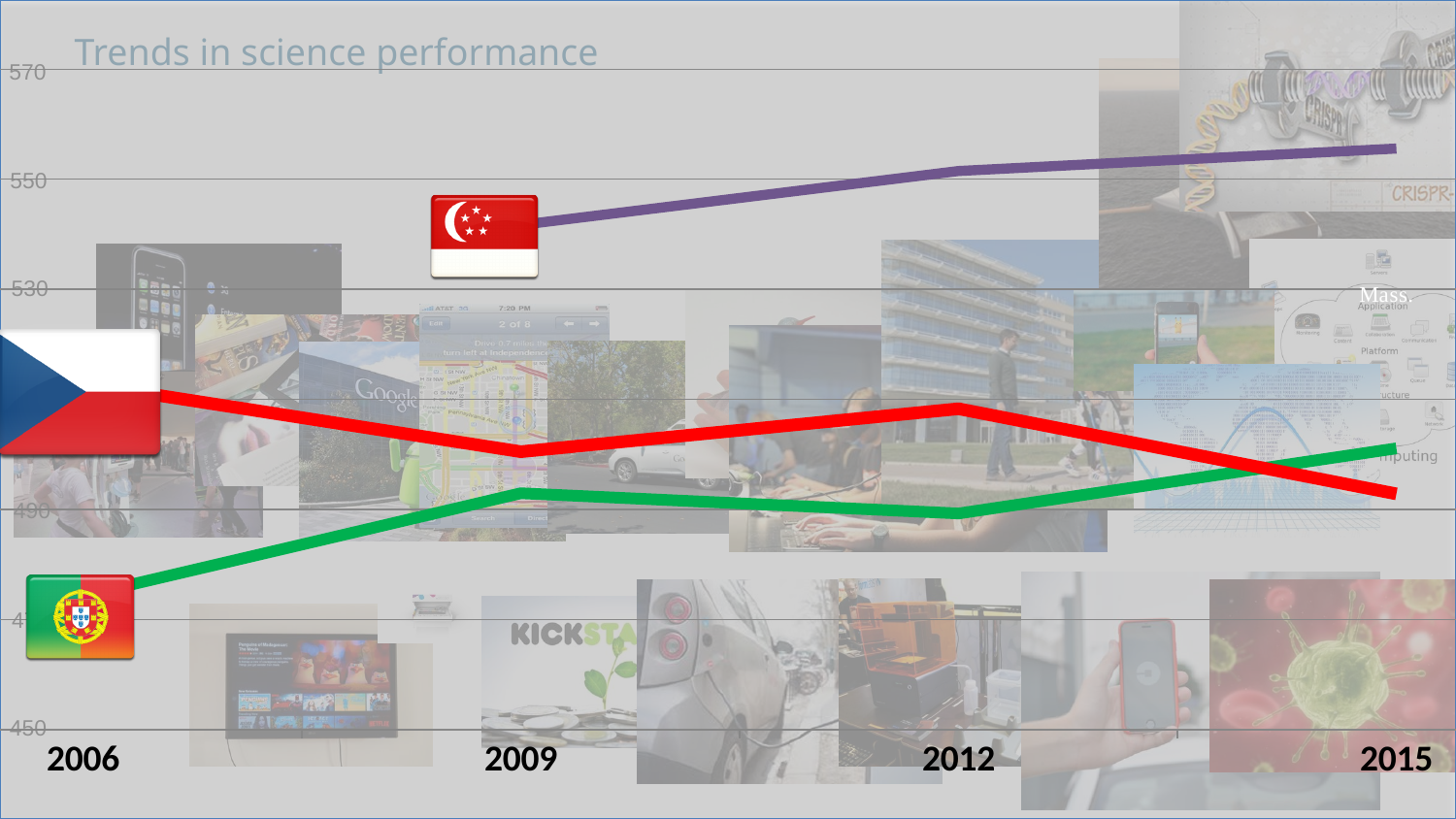
Does the purple line rise or fall from 2009 to 2015? rise Which line is the highest on the chart across all years shown? the purple line Is the value of the purple line in 2015 greater or less than 550? greater What kind of chart is shown on the slide? line chart What is the title of the chart? Trends in science performance Is the value of the red line in 2015 greater or less than 510? less Is the value of the green line in 2006 greater or less than 490? less Which line is the lowest in 2006? the green line How many years are labelled on the x axis of the chart? 4 How many lines are plotted on the chart? 3 Does the red line rise or fall overall from 2006 to 2015? fall In 2015, which is higher, the green line or the red line? the green line